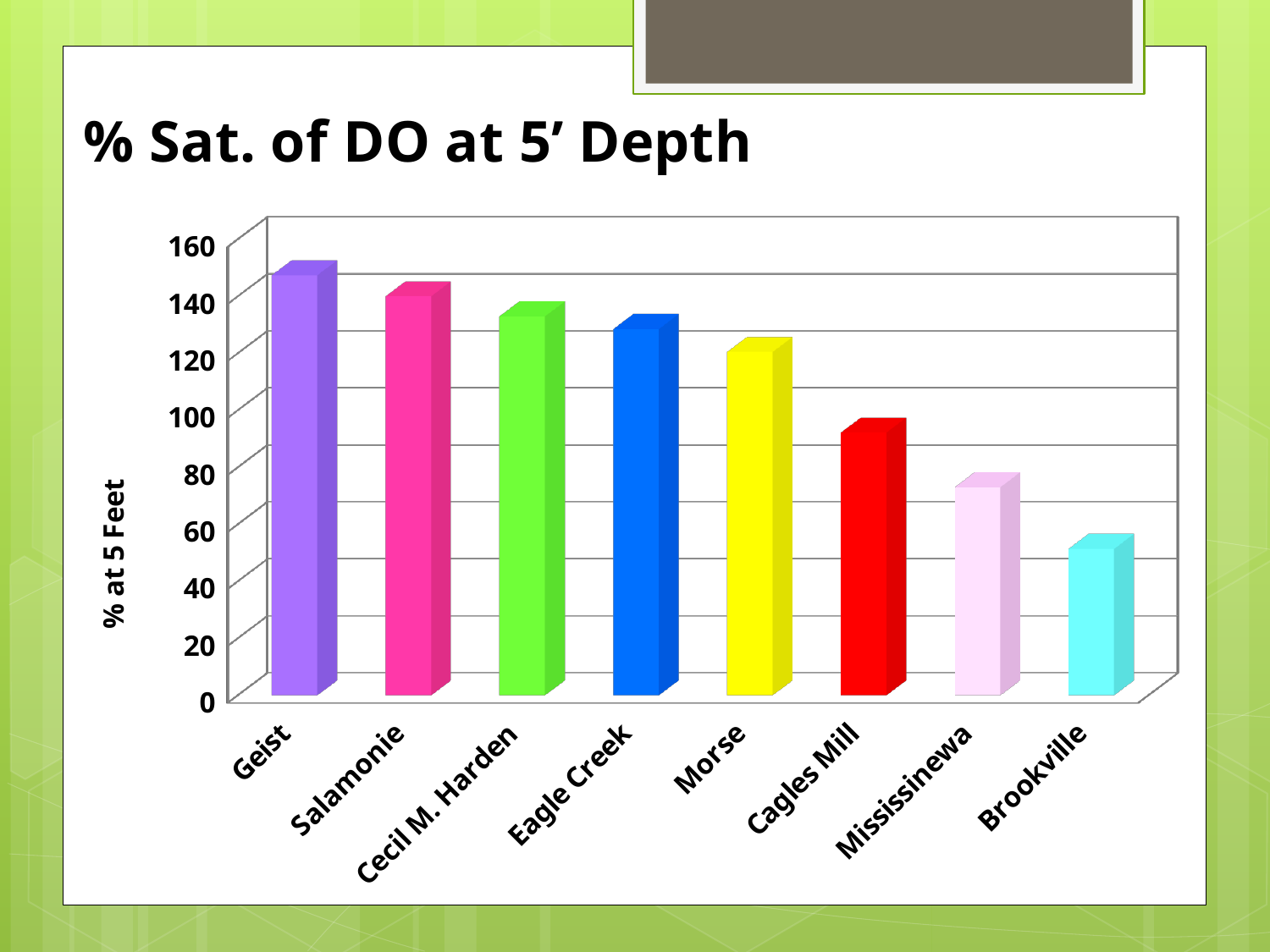
What kind of chart is shown on the slide? bar chart Is the value for Eagle Creek greater or less than 120? greater Which is larger, the value for Cagles Mill or the value for Mississinewa? Cagles Mill How many reservoirs (categories) are shown on the x axis? 8 Is the value for Geist greater or less than 140? greater Do the values rise or fall moving from left to right along the x axis? fall Is the value for Mississinewa greater or less than 80? less What is the label on the vertical axis of the chart? % at 5 Feet Which reservoir has the lowest % saturation of DO at 5' depth? Brookville Which reservoir has the highest % saturation of DO at 5' depth? Geist